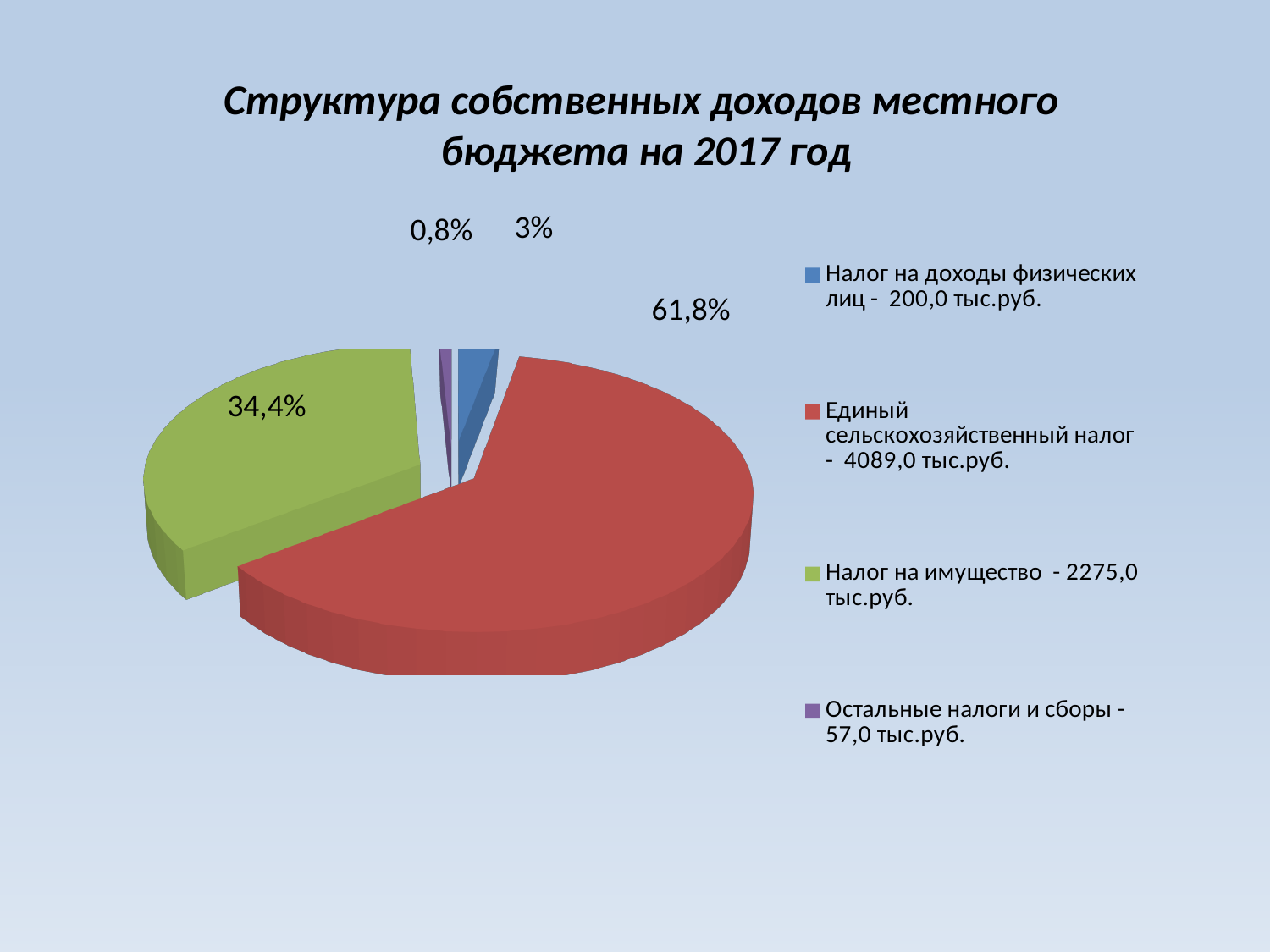
What share of the pie does Налог на имущество have? 34,4% What share of the pie does Налог на доходы физических лиц have? 3% Which is larger, the share for Налог на имущество or the share for Налог на доходы физических лиц? Налог на имущество Which category has the smallest slice of the pie? Остальные налоги и сборы What amount in тыс.руб. does the legend give for Единый сельскохозяйственный налог? 4089,0 тыс.руб. Which category has the largest slice of the pie? Единый сельскохозяйственный налог How many slices does the pie chart have? 4 What is the title of the chart? Структура собственных доходов местного бюджета на 2017 год What kind of chart is shown on the slide? pie chart What share of the pie does Остальные налоги и сборы have? 0,8% What amount in тыс.руб. does the legend give for Налог на имущество? 2275,0 тыс.руб.